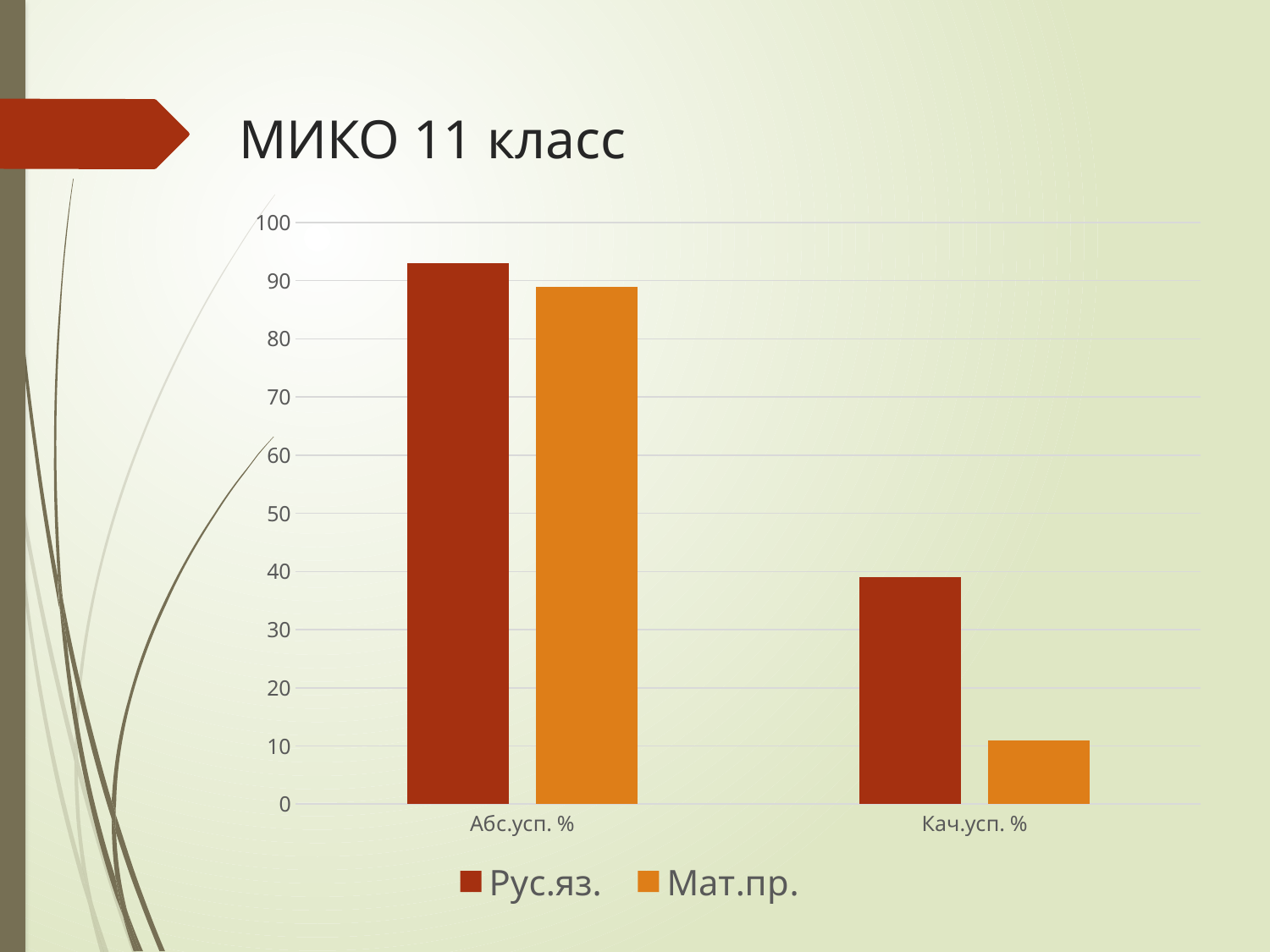
How many categories are shown on the x axis? 2 What is the title of the slide containing the chart? МИКО 11 класс Which category has the highest value for Рус.яз.? Абс.усп. % Is the value for Мат.пр. in Абс.усп. % greater or less than 80? greater Which series has the larger value in Кач.усп. %? Рус.яз. Which series is shown in dark red in the legend? Рус.яз. Is the value for Мат.пр. in Кач.усп. % greater or less than 20? less What kind of chart is shown on the slide? bar chart Which category has the lowest value for Мат.пр.? Кач.усп. % Is the value for Рус.яз. in Абс.усп. % greater or less than 90? greater How many series does the legend list? 2